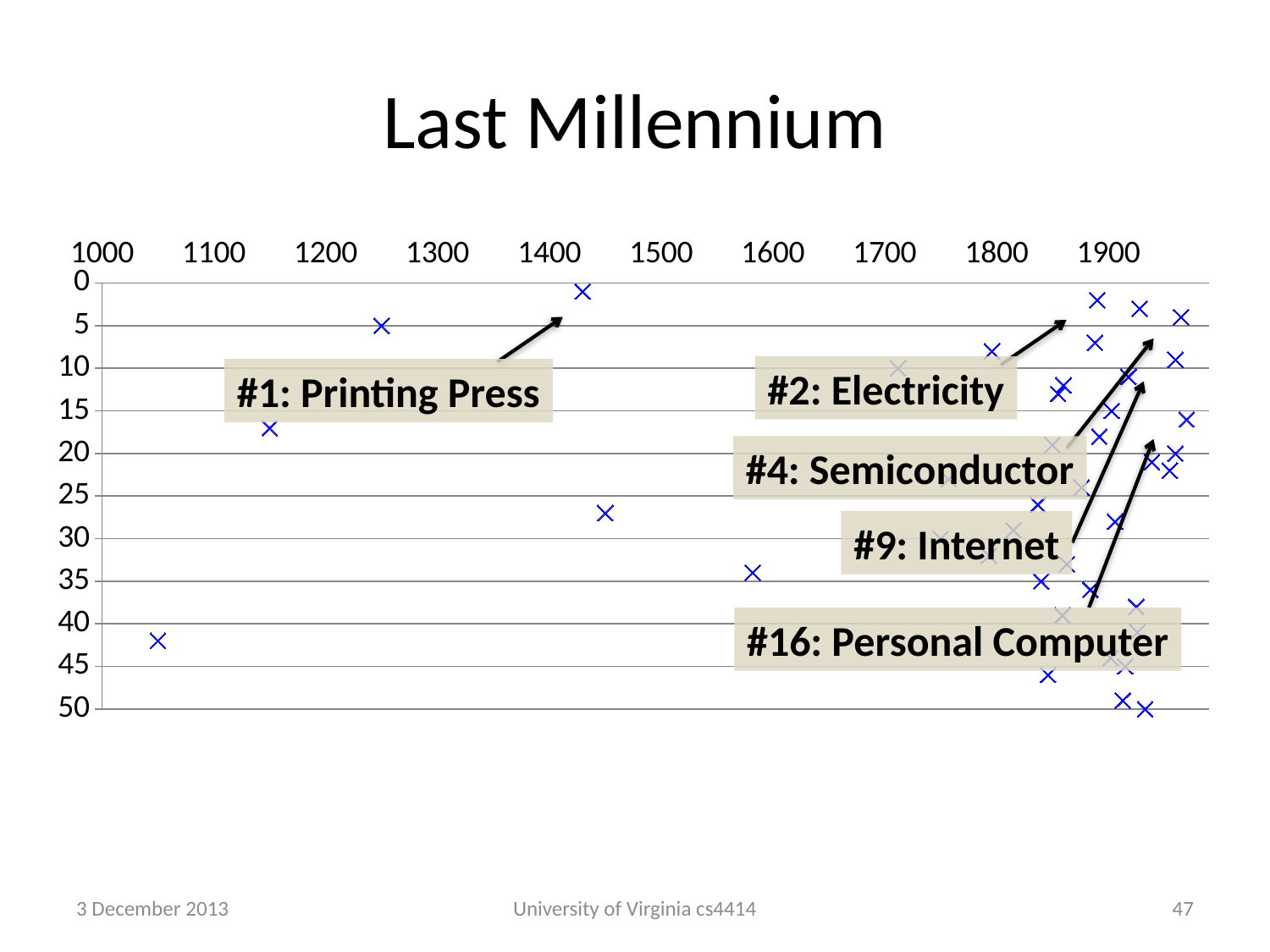
Is the y value of the leftmost point (near year 1050) greater or less than 30? greater What kind of chart is shown on the slide? scatter chart Is the y value of the point near year 1580 greater or less than 25? greater Which invention is annotated as #16 on the chart? Personal Computer Is the y value of the point near year 1450 greater or less than 20? greater Which invention is annotated as #1 on the chart? Printing Press Which invention is annotated as #4 on the chart? Semiconductor What is the earliest year shown on the x axis of the chart? 1000 Which invention is annotated as #2 on the chart? Electricity Which invention is annotated as #9 on the chart? Internet How many inventions are called out with labelled annotations on the chart? 5 What is the title of the slide's chart? Last Millennium